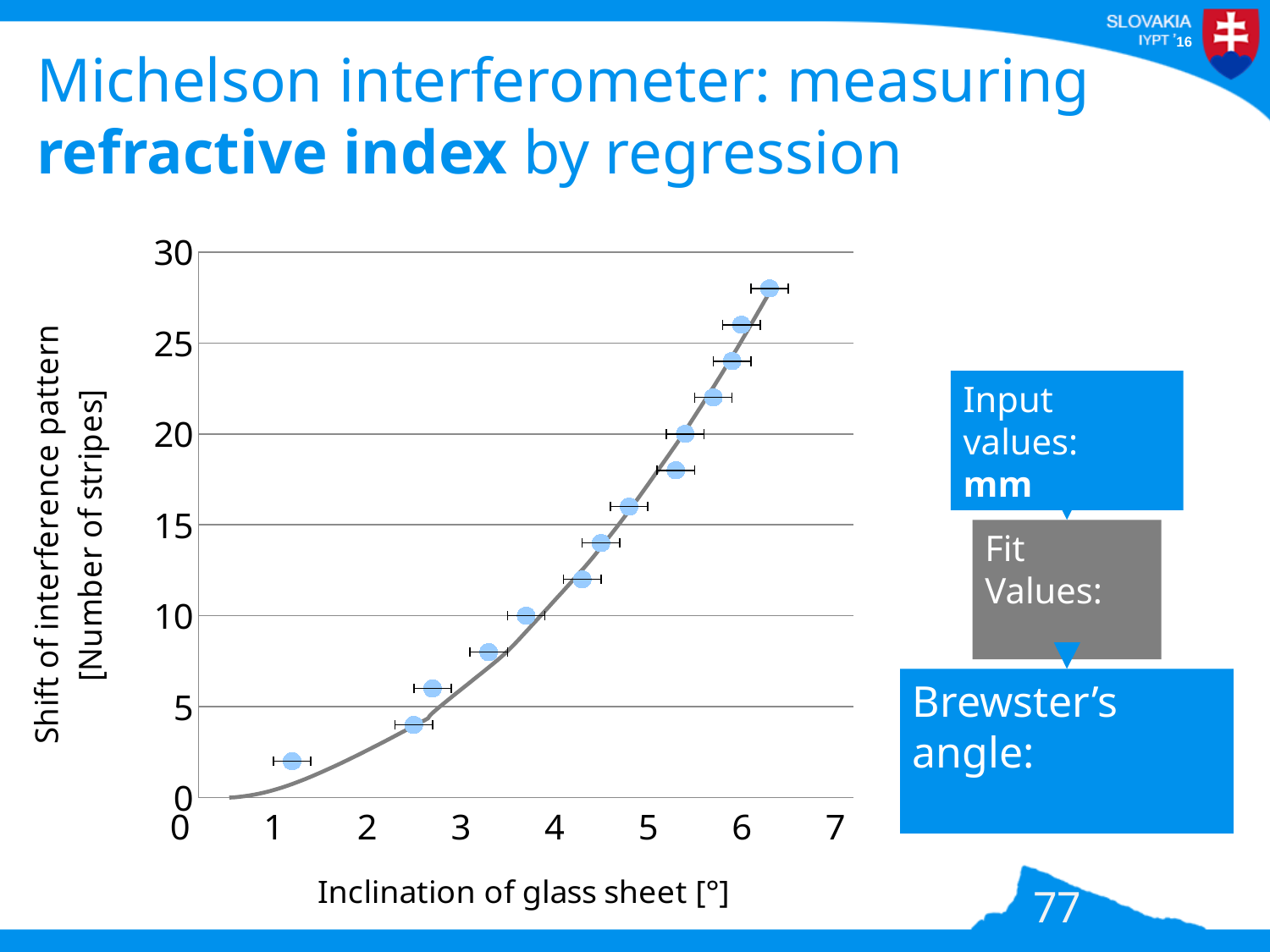
What is the title of the x axis? Inclination of glass sheet [°] What is the title of the y axis? Shift of interference pattern [Number of stripes] Which has the larger shift: the point at about 2.5° inclination or the point at about 4.3° inclination? The point at about 4.3° Is the shift value for the point at about 3.3° inclination greater or less than 10? less Is the inclination of the highest plotted point greater or less than 6°? greater Is the shift value for the point at about 5.7° inclination greater or less than 20? greater Does the point with the highest shift also have the highest inclination? Yes What kind of chart is shown on the slide? Scatter chart with a fitted curve Does the shift of the interference pattern rise or fall as the inclination of the glass sheet increases? Rise